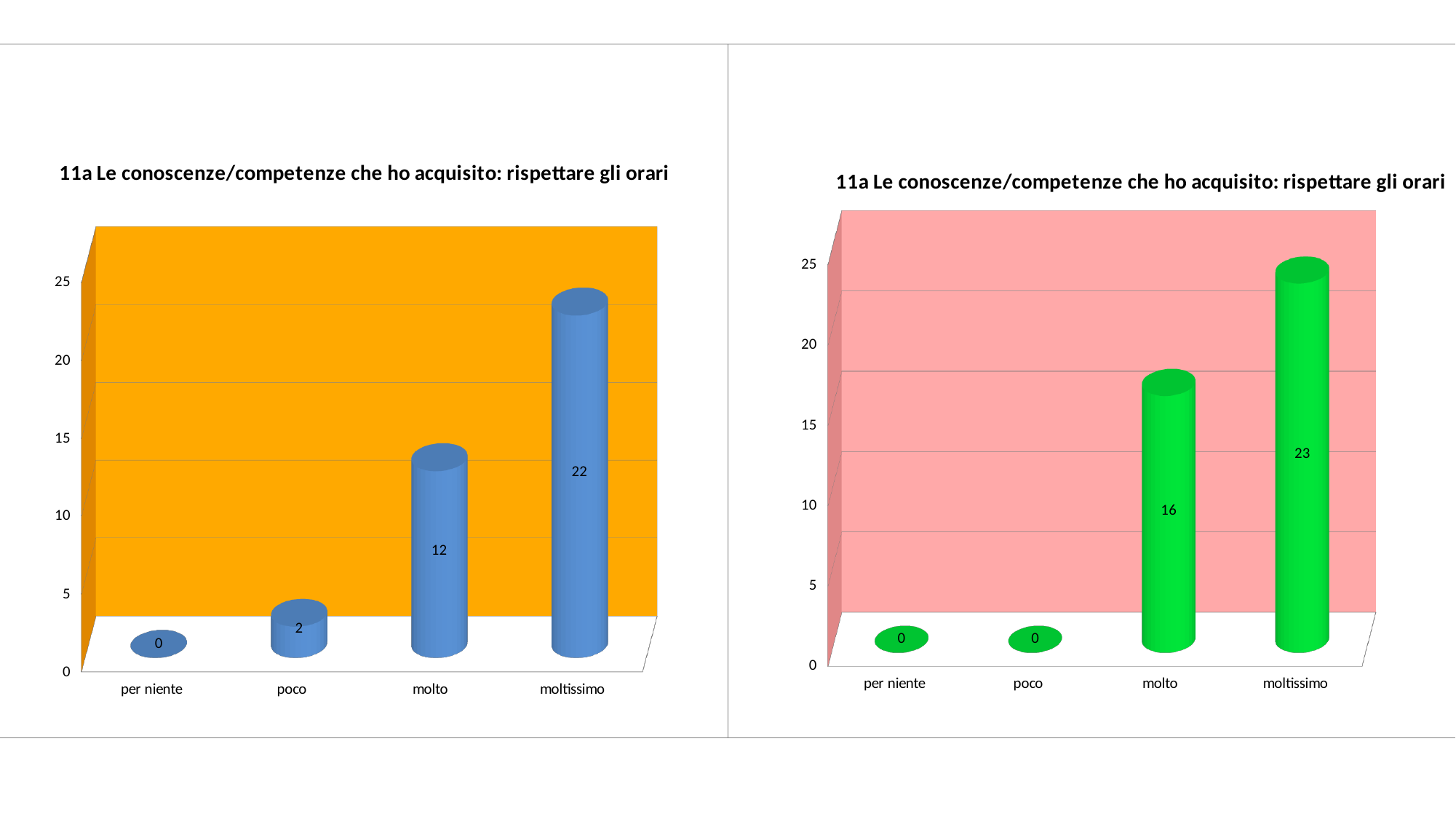
What kind of chart is the left chart? bar chart In the left chart, what is the difference between the values for moltissimo and molto? 10 In the right chart, what is the difference between the values for moltissimo and molto? 7 In the left chart, what is the value for poco? 2 In the right chart, what is the value for moltissimo? 23 How many categories are shown on the x axis of the right chart? 4 In the right chart, do the values rise or fall from per niente to moltissimo? rise Which is larger: the value for molto in the left chart or the value for molto in the right chart? the right chart (16) In the left chart, what is the value for moltissimo? 22 In the left chart, which category has the highest value? moltissimo In the right chart, what is the value for molto? 16 In the left chart, which category has the lowest value? per niente